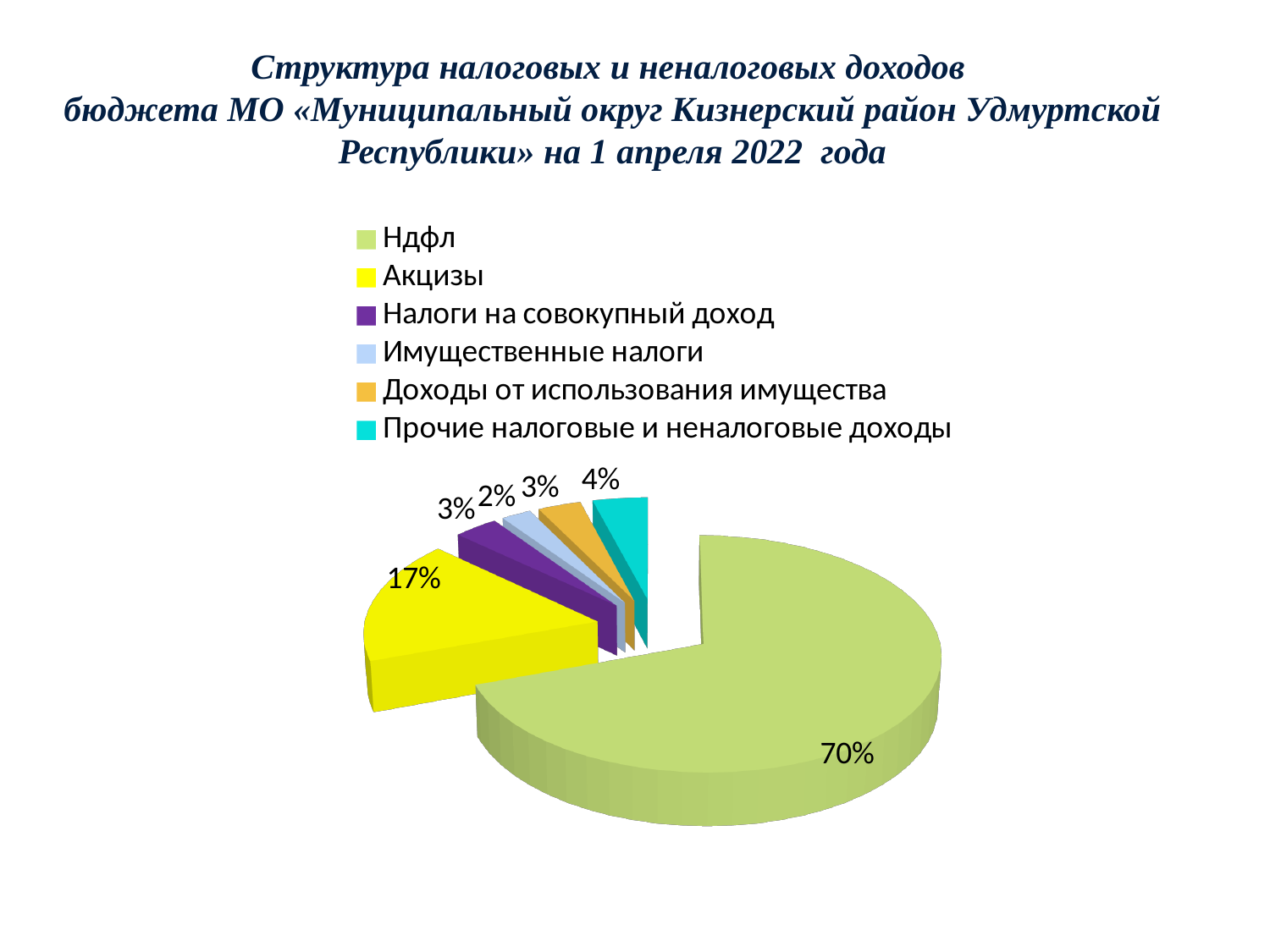
What kind of chart is shown on the slide? pie chart Which category has the largest slice of the pie? Ндфл What is the difference in percentage points between the Ндфл slice and the Акцизы slice? 53 What share of the pie does Акцизы have? 17% How many categories does the legend list? 6 What share of the pie does Налоги на совокупный доход have? 3% Which is larger, the Акцизы slice or the Прочие налоговые и неналоговые доходы slice? Акцизы What share of the pie does Имущественные налоги have? 2% What colour is the Акцизы slice? yellow Which category has the smallest slice of the pie? Имущественные налоги